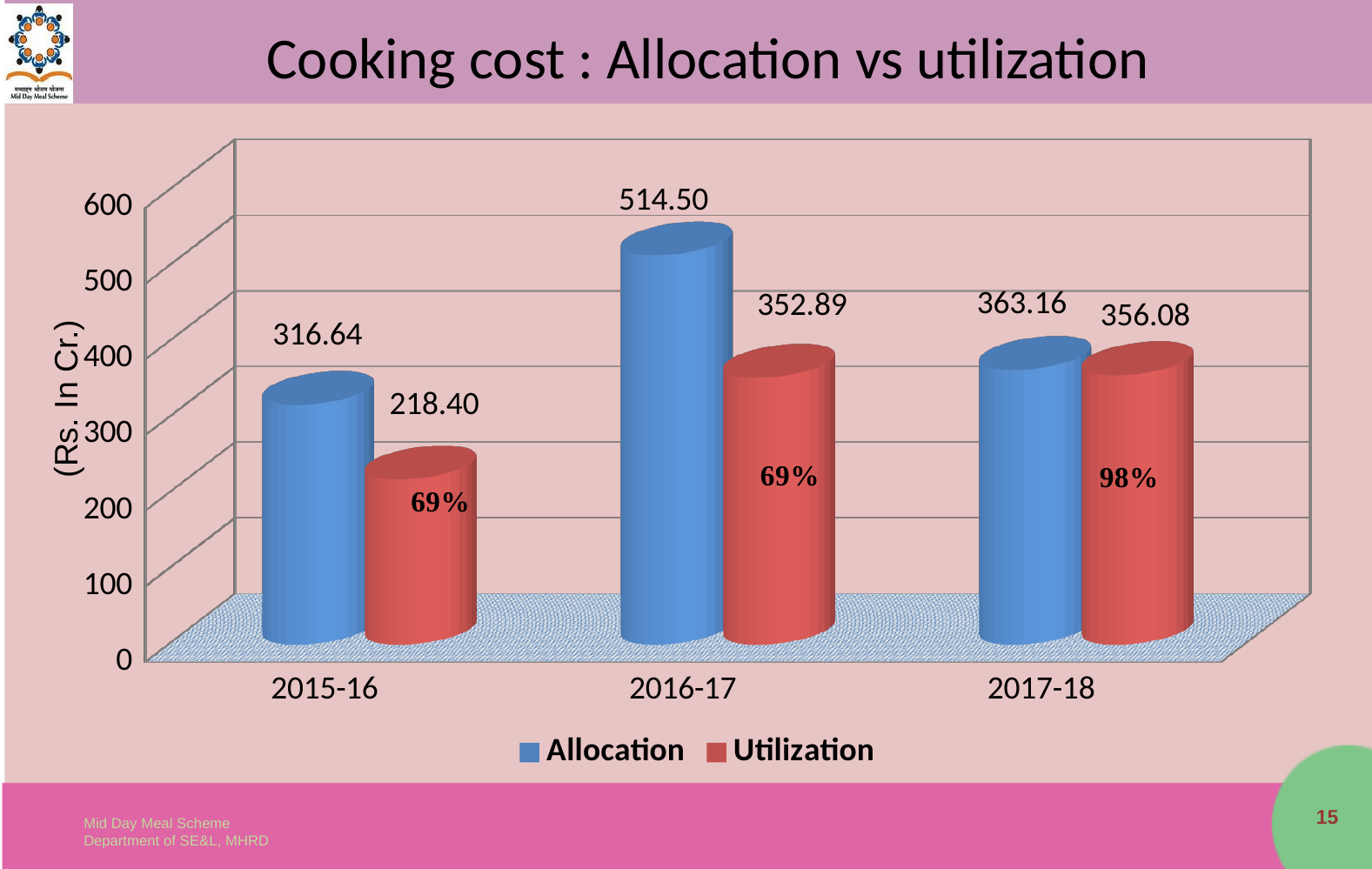
What is the Utilization value for 2015-16? 218.40 Which year has the lowest Utilization? 2015-16 Which is larger in 2015-16, Allocation or Utilization? Allocation What utilization percentage is printed on the 2017-18 Utilization bar? 98% What is the Allocation value for 2017-18? 363.16 What is the Utilization value for 2017-18? 356.08 Which year has the highest Allocation? 2016-17 How many years are shown on the x axis? 3 What is the difference between Allocation and Utilization in 2016-17? 161.61 How many series does the legend list? 2 What kind of chart is shown on the slide? Bar chart What is the Allocation value for 2016-17? 514.50